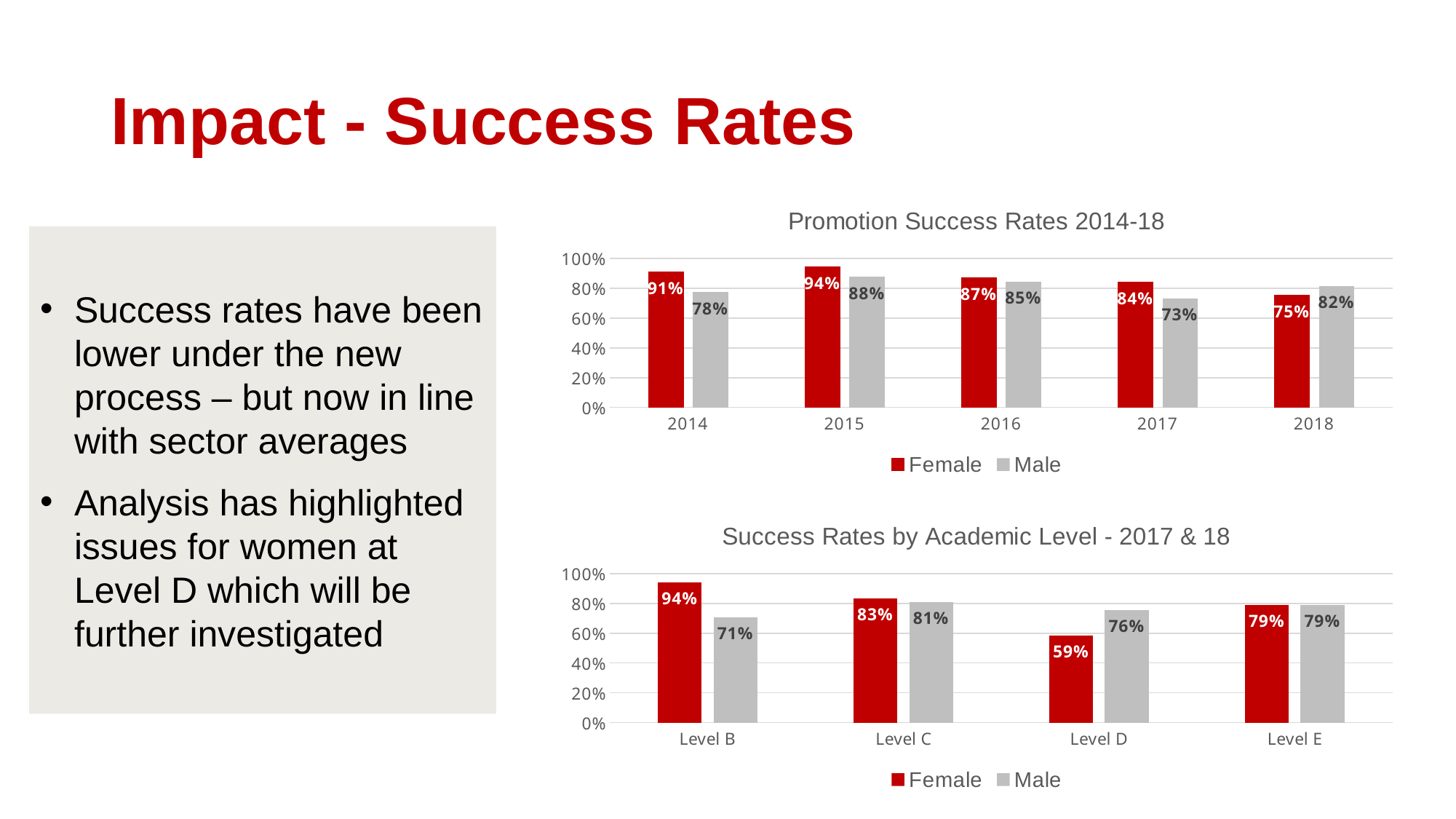
In the 'Promotion Success Rates 2014-18' chart, which year has the lowest Female success rate? 2018 In the 'Success Rates by Academic Level - 2017 & 18' chart, what is the Female success rate at Level D? 59% In the 'Success Rates by Academic Level - 2017 & 18' chart, is the Female or Male rate higher at Level D? Male In the 'Success Rates by Academic Level - 2017 & 18' chart, what is the difference between the Male and Female rates at Level B? 23% In the 'Promotion Success Rates 2014-18' chart, does the Female success rate rise or fall from 2015 to 2018? fall In the 'Promotion Success Rates 2014-18' chart, how many years are shown on the x axis? 5 In the 'Promotion Success Rates 2014-18' chart, what is the Male success rate in 2017? 73% In the 'Success Rates by Academic Level - 2017 & 18' chart, which level has the highest Female success rate? Level B What type of chart is the 'Promotion Success Rates 2014-18' chart? Bar chart In the 'Promotion Success Rates 2014-18' chart, what is the difference between the Female and Male rates in 2014? 13% In the 'Promotion Success Rates 2014-18' chart, what is the Female success rate in 2015? 94% How many series does the legend of the 'Success Rates by Academic Level - 2017 & 18' chart list? 2